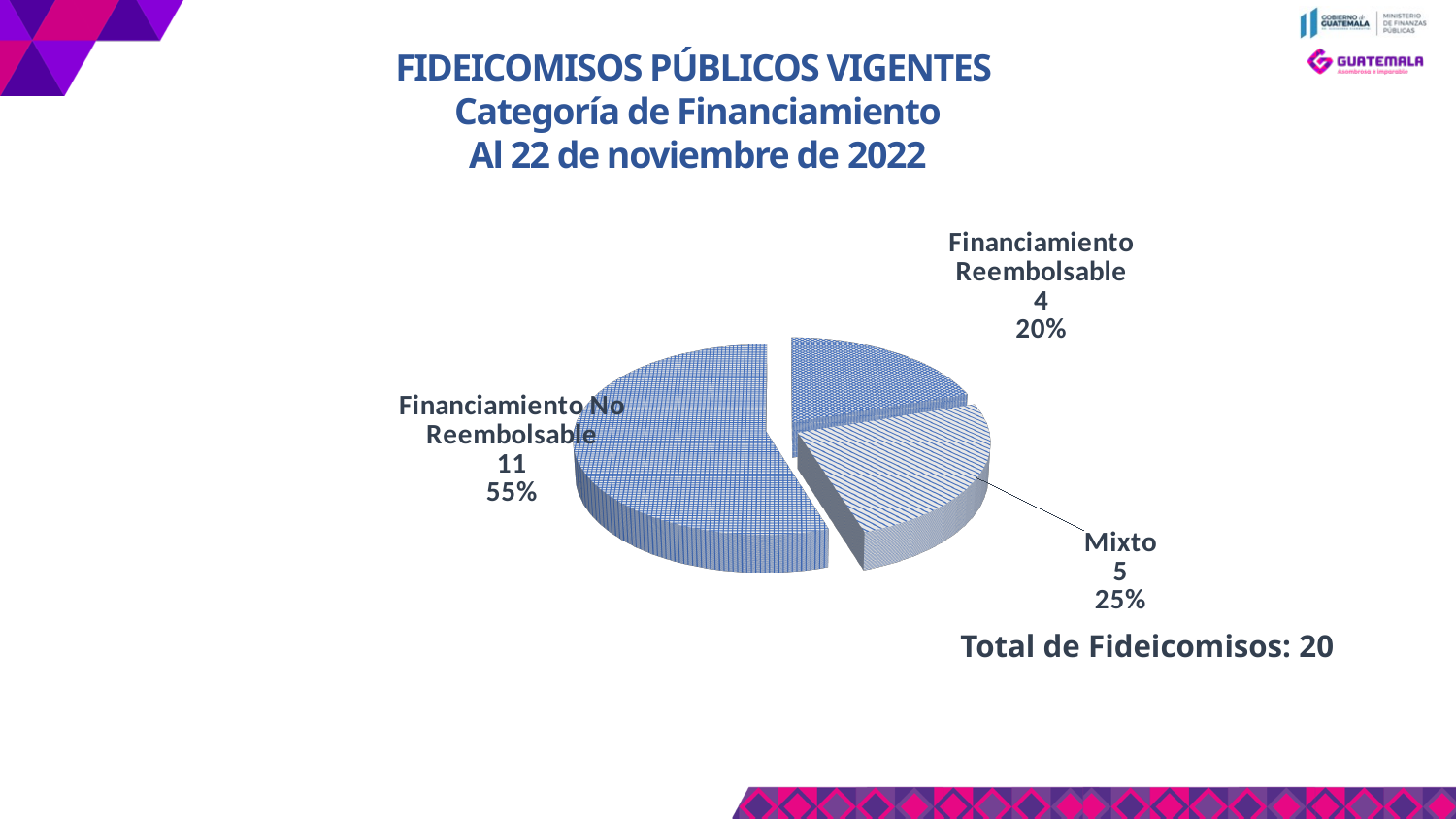
How many fideicomisos are in the Financiamiento No Reembolsable category? 11 What is the total number of fideicomisos stated on the slide? 20 What share of the pie does Financiamiento Reembolsable represent? 20% What is the difference between the number of fideicomisos in Financiamiento No Reembolsable and Mixto? 6 How many fideicomisos are in the Financiamiento Reembolsable category? 4 What type of chart is shown on the slide? Pie chart Which category has the largest number of fideicomisos? Financiamiento No Reembolsable Which category has the smallest number of fideicomisos? Financiamiento Reembolsable How many categories does the pie chart show? 3 What share of the pie does Financiamiento No Reembolsable represent? 55% What share of the pie does Mixto represent? 25% How many fideicomisos are in the Mixto category? 5